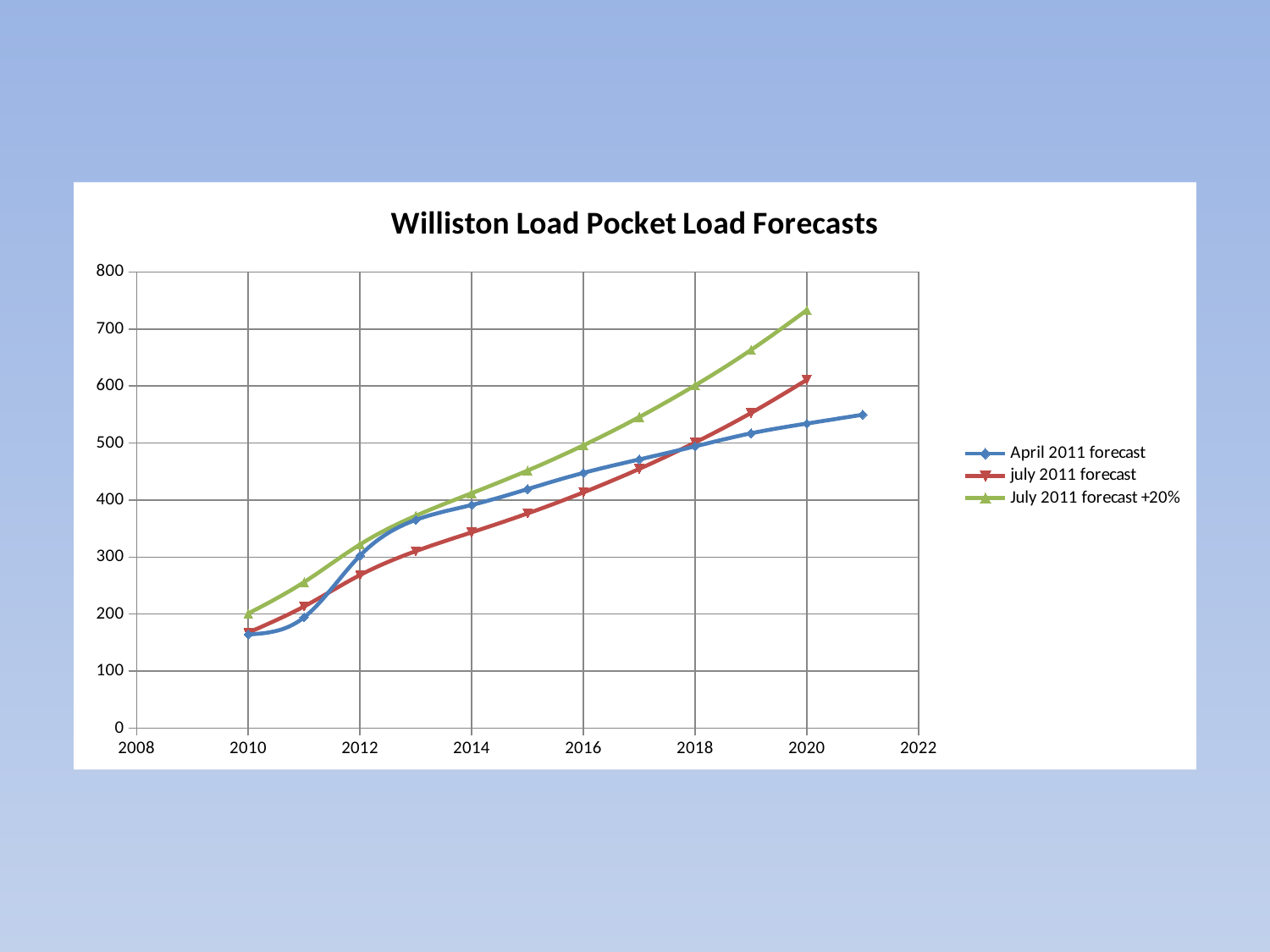
In 2020, which is larger: the july 2011 forecast or the April 2011 forecast? july 2011 forecast What is the title of the chart? Williston Load Pocket Load Forecasts Is the value of the April 2011 forecast series in 2021 greater or less than 500? greater How many data points does the April 2011 forecast series have? 12 What kind of chart is shown on the slide? line chart How many series does the legend list? 3 Is the value of the July 2011 forecast +20% series in 2020 greater or less than 700? greater Which series has the highest value in 2020? July 2011 forecast +20% Which series has the lowest value in 2014? july 2011 forecast Is the value of the July 2011 forecast +20% series in 2019 greater or less than 600? greater Does the April 2011 forecast rise or fall from 2010 to 2021? rise